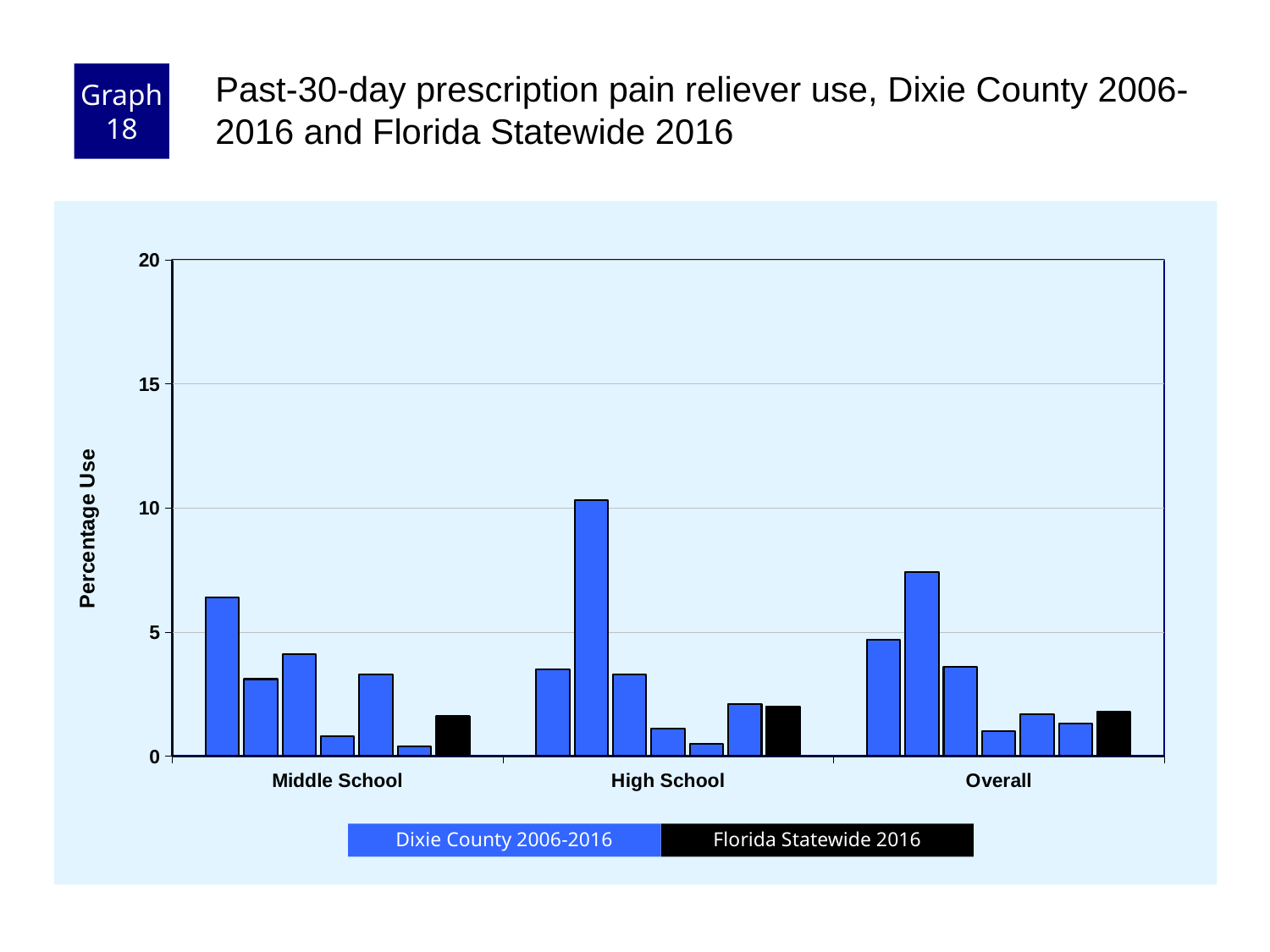
Is the Florida Statewide 2016 value for High School greater or less than 5? less Is the tallest Dixie County 2006-2016 bar in the High School group greater or less than 5? greater In the Overall group, which is larger: the tallest Dixie County 2006-2016 bar or the Florida Statewide 2016 bar? the tallest Dixie County 2006-2016 bar Is the Florida Statewide 2016 value for Middle School greater or less than 5? less What is the highest value shown on the y axis? 20 How many series does the chart legend list? 2 How many categories are shown on the x axis of the chart? 3 Which x-axis category contains the tallest bar in the chart? High School What is the label of the y axis? Percentage Use What kind of chart is shown on the slide? bar chart Which colour represents Florida Statewide 2016 in the chart? black